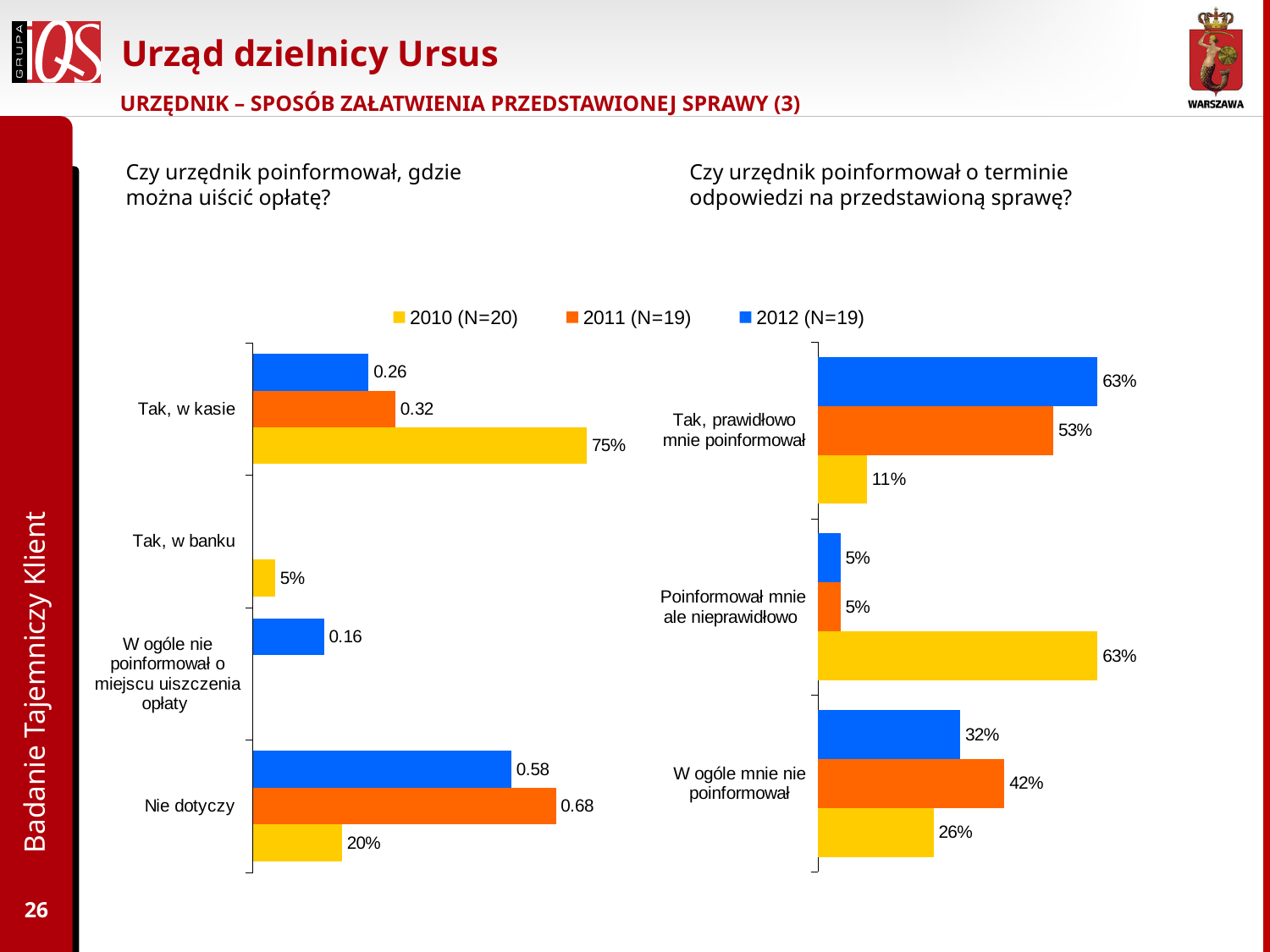
In the right chart (Czy urzędnik poinformował o terminie odpowiedzi na przedstawioną sprawę?), what is the value for 2012 (N=19) in the 'Tak, prawidłowo mnie poinformował' category? 63% In the right chart (Czy urzędnik poinformował o terminie odpowiedzi na przedstawioną sprawę?), which category has the lowest value for 2010 (N=20)? Tak, prawidłowo mnie poinformował In the right chart (Czy urzędnik poinformował o terminie odpowiedzi na przedstawioną sprawę?), how many categories are shown? 3 In the left chart (Czy urzędnik poinformował, gdzie można uiścić opłatę?), what is the value for 2010 (N=20) in the 'Tak, w kasie' category? 75% In the left chart (Czy urzędnik poinformował, gdzie można uiścić opłatę?), what is the value for 2011 (N=19) in the 'Nie dotyczy' category? 0.68 In the left chart (Czy urzędnik poinformował, gdzie można uiścić opłatę?), which category has the highest value for 2010 (N=20)? Tak, w kasie In the left chart (Czy urzędnik poinformował, gdzie można uiścić opłatę?), which is larger for 'Nie dotyczy': 2011 (N=19) or 2012 (N=19)? 2011 (N=19) In the right chart (Czy urzędnik poinformował o terminie odpowiedzi na przedstawioną sprawę?), what is the difference between the 2011 (N=19) and 2012 (N=19) values for 'W ogóle mnie nie poinformował'? 10% In the left chart (Czy urzędnik poinformował, gdzie można uiścić opłatę?), what is the value for 2012 (N=19) in the 'W ogóle nie poinformował o miejscu uiszczenia opłaty' category? 0.16 In the right chart (Czy urzędnik poinformował o terminie odpowiedzi na przedstawioną sprawę?), what is the value for 2010 (N=20) in the 'Poinformował mnie ale nieprawidłowo' category? 63% How many series does the legend list? 3 What kind of chart is the left chart (Czy urzędnik poinformował, gdzie można uiścić opłatę?)? Bar chart